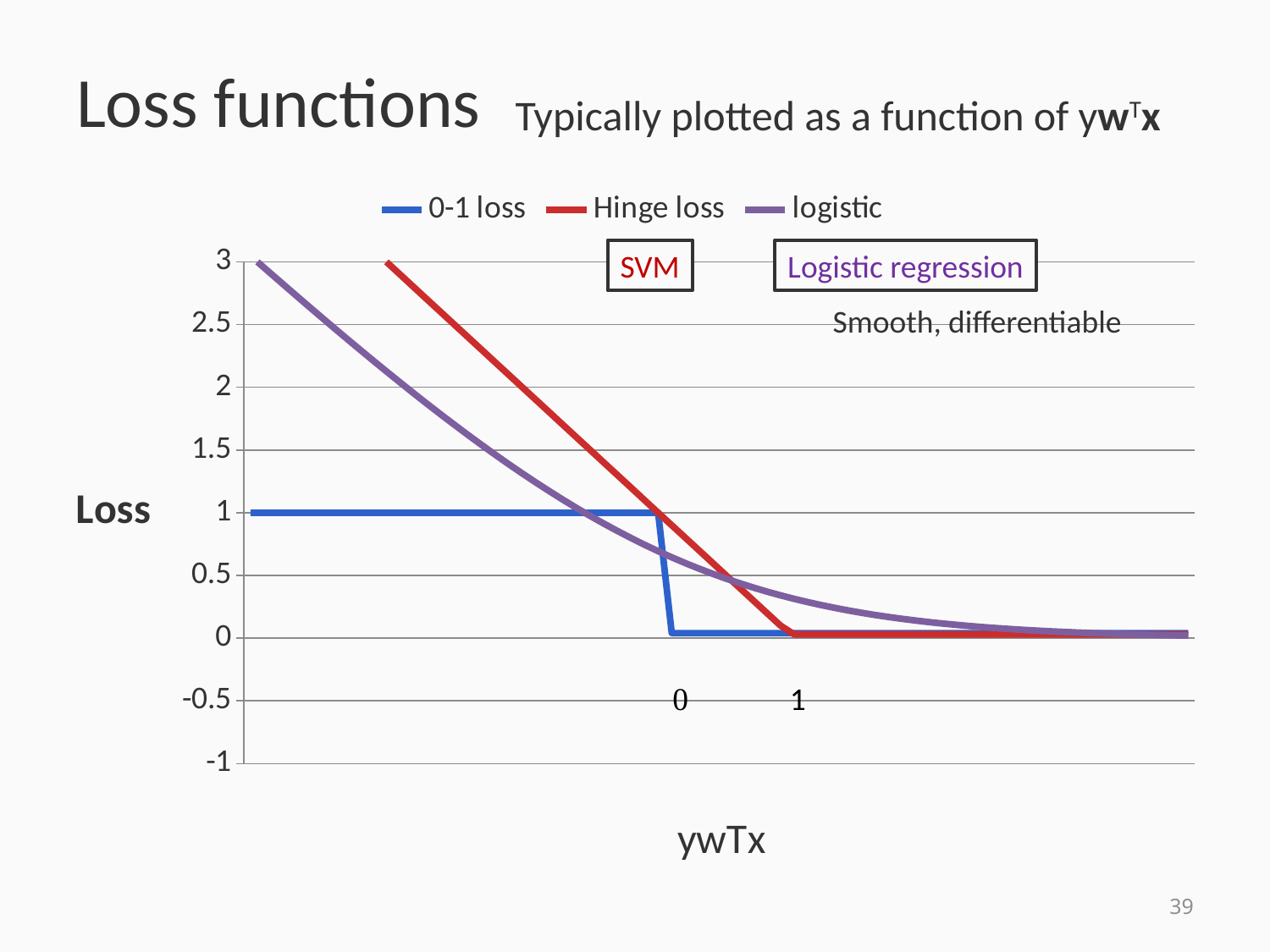
Is the logistic loss at ywTx = 1 greater or less than 1? less What kind of chart is shown on the slide? line chart Do the loss values rise or fall as ywTx increases? fall What is the highest value shown on the Loss axis? 3 At ywTx = 1, which series has the highest loss? logistic Which series is annotated with the label 'SVM'? Hinge loss Is the Hinge loss at ywTx = 0 greater or less than 0.5? greater How many series does the legend list? 3 At ywTx = 1, which is larger, the Hinge loss or the logistic loss? logistic What is the value of the 0-1 loss for negative values of ywTx? 1